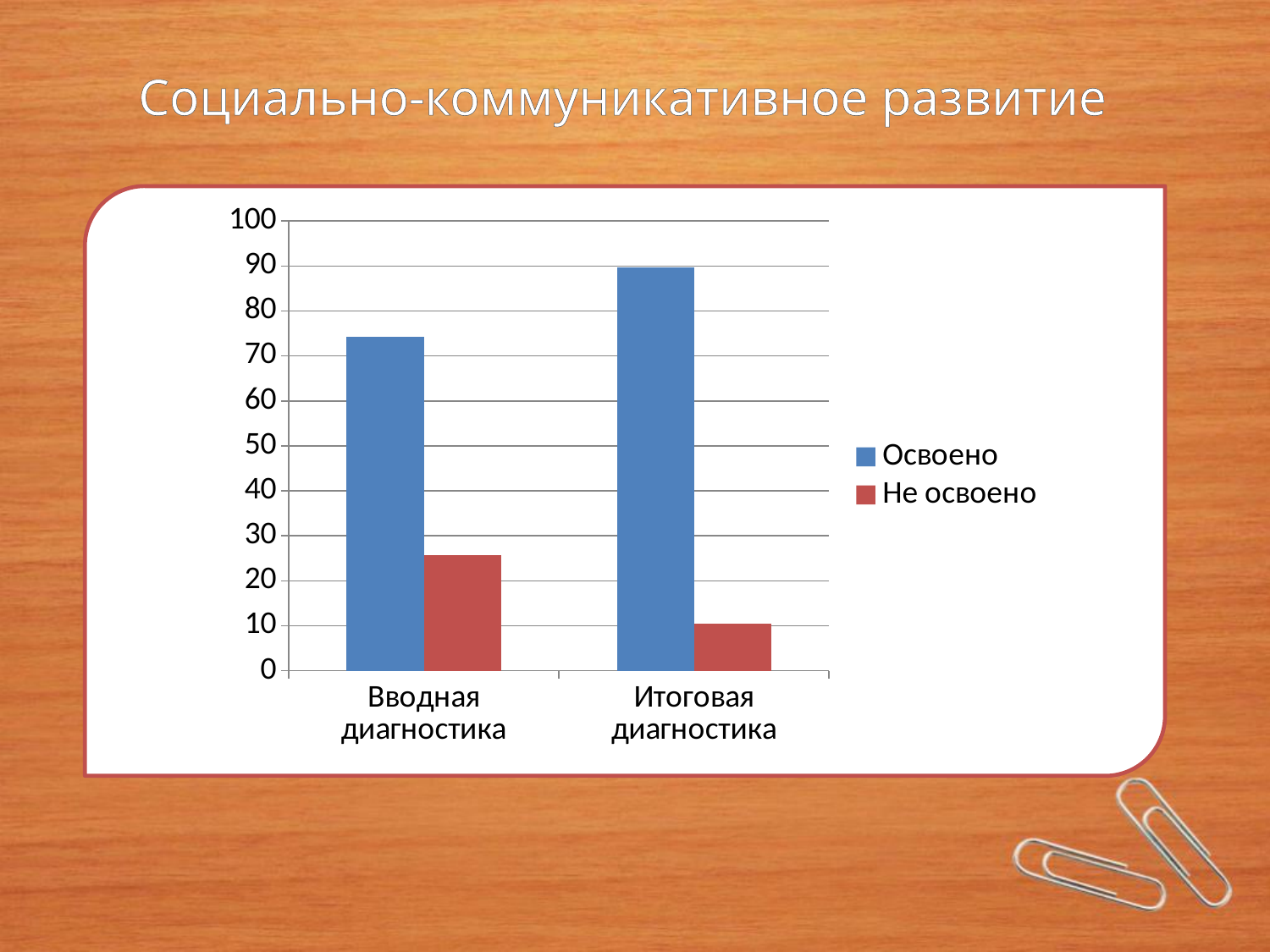
Which category has the higher value for Освоено, Вводная диагностика or Итоговая диагностика? Итоговая диагностика What kind of chart is shown on the slide? bar chart Is the value for Освоено at Вводная диагностика greater or less than 70? greater Does the value for Не освоено rise or fall from Вводная диагностика to Итоговая диагностика? fall Is the value for Не освоено at Вводная диагностика greater or less than 30? less Is the value for Освоено at Итоговая диагностика greater or less than 80? greater What is the title of the slide containing the chart? Социально-коммуникативное развитие Which series is shown in blue? Освоено How many categories are shown on the x axis? 2 How many series does the legend list? 2